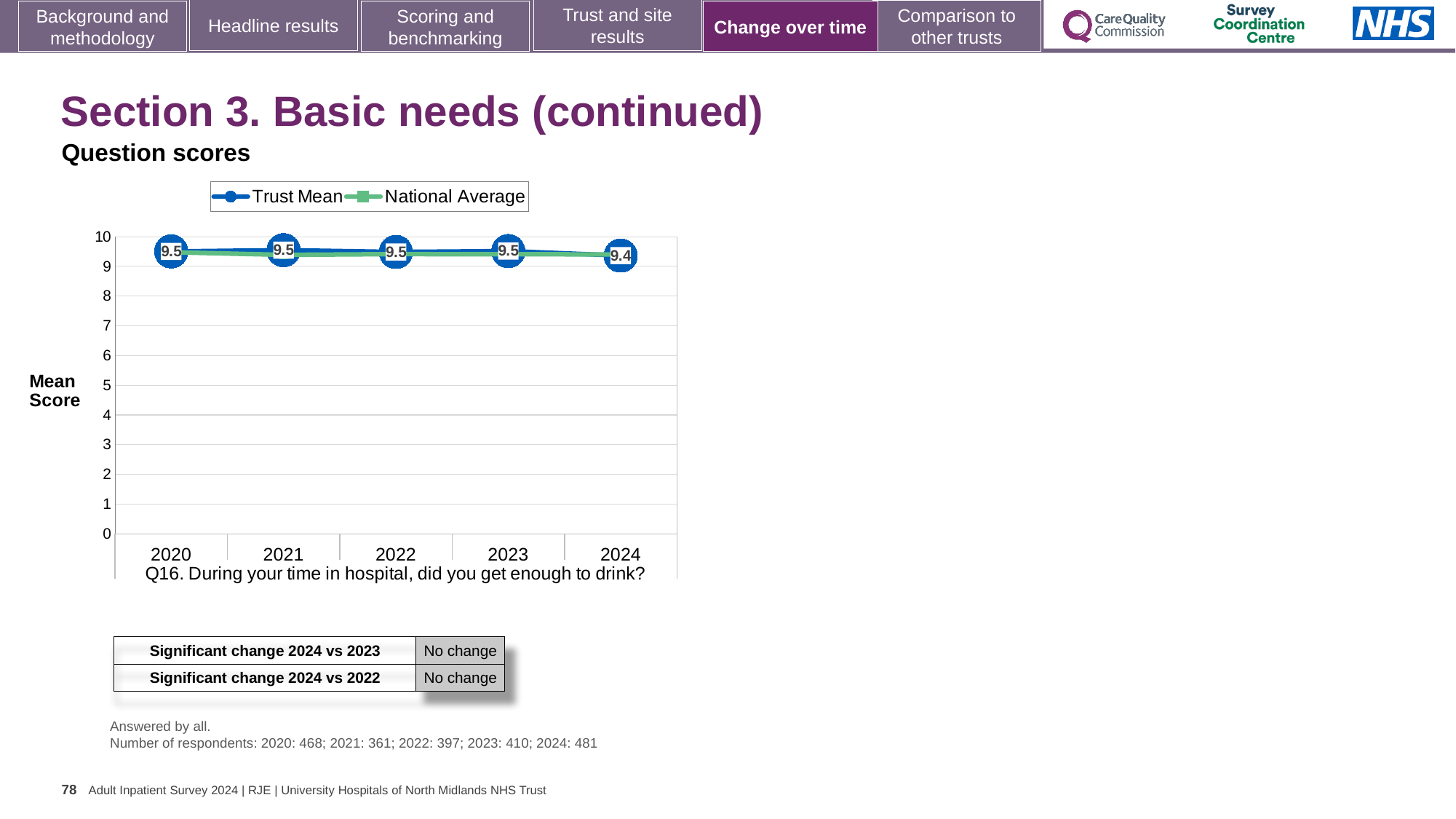
How many years are plotted on the x axis? 5 What is the difference between the Trust Mean score in 2020 and in 2024? 0.1 Is the National Average value for 2024 greater or less than 9? greater Does the Trust Mean score rise or fall from 2020 to 2024? Fall Is the Trust Mean score higher in 2023 or in 2024? 2023 How many series does the legend list? 2 What kind of chart is shown on the slide? Line chart What is the Trust Mean score for 2024? 9.4 What survey question does the chart relate to? Q16. During your time in hospital, did you get enough to drink? Which year has the lowest Trust Mean score? 2024 What is the Trust Mean score for 2022? 9.5 What is the Trust Mean score for 2020? 9.5